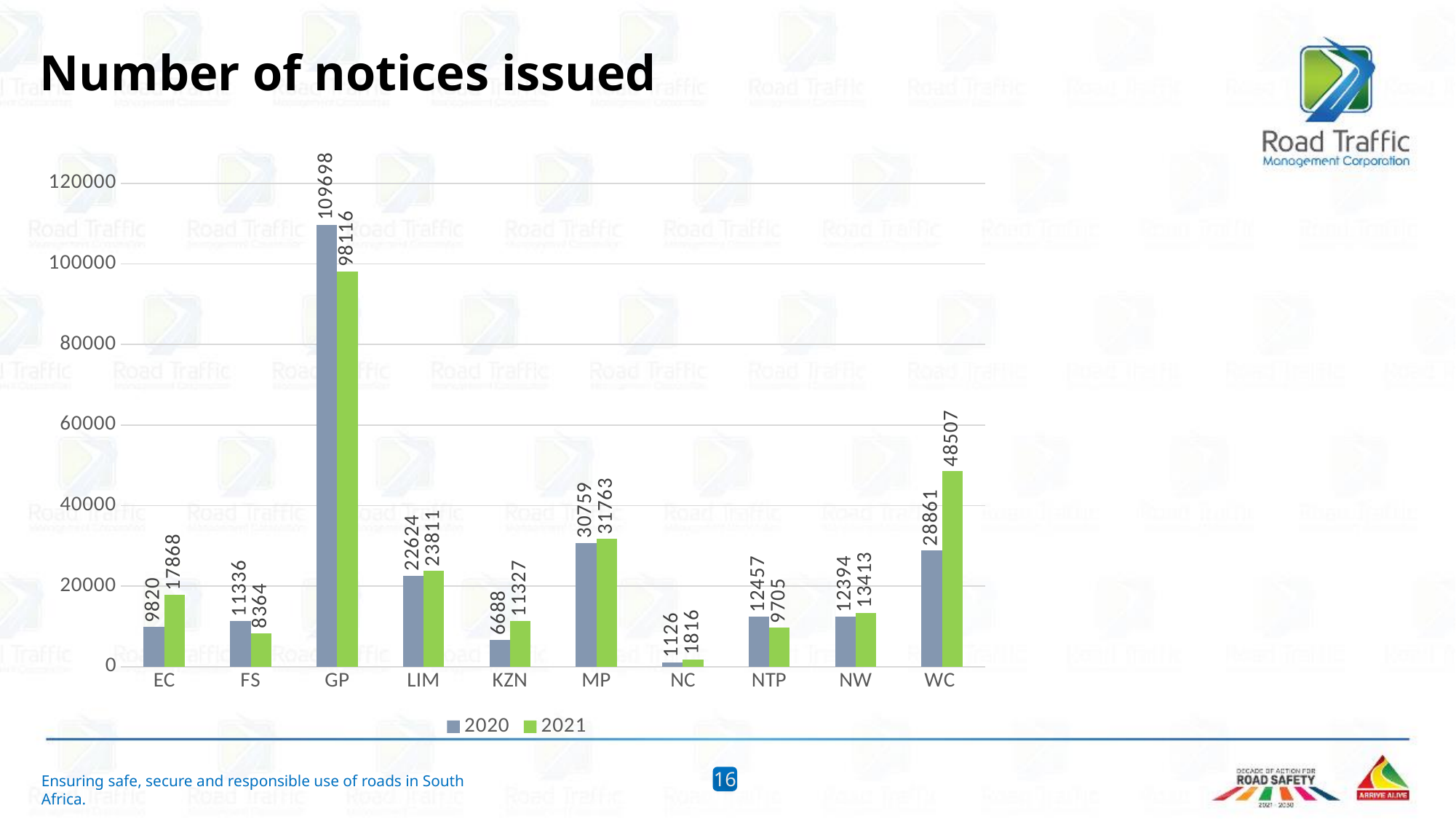
What is the difference between the 2021 and 2020 values for WC? 19646 Which province has the highest number of notices issued in 2021? GP What is the value for NC in 2020? 1126 What is the number of notices issued in WC in 2021? 48507 What kind of chart is shown on the slide? bar chart What is the number of notices issued in GP in 2020? 109698 What is the difference between the 2020 and 2021 values for GP? 11582 Is the 2021 value for MP greater or less than 40000? less Which province has the lowest number of notices issued in 2020? NC Which is larger for FS: the 2020 value or the 2021 value? 2020 How many provinces are shown on the x axis? 10 How many series does the legend list? 2